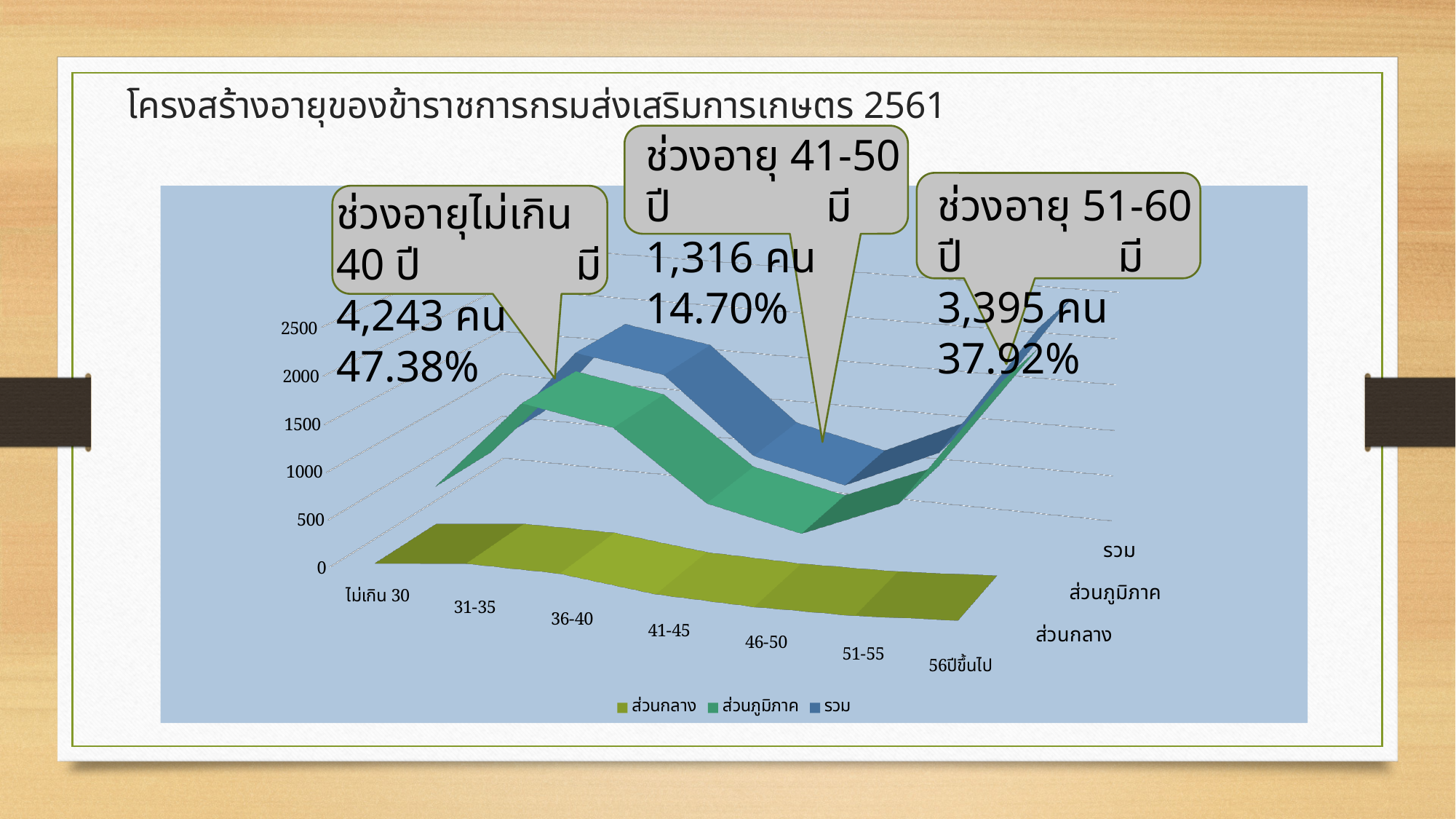
What is the title of the slide's chart? โครงสร้างอายุของข้าราชการกรมส่งเสริมการเกษตร 2561 How many series does the chart legend list? 3 Which series is shown in blue in the chart legend? รวม What is the first age category on the x axis of the chart? ไม่เกิน 30 What is the last age category on the x axis of the chart? 56ปีขึ้นไป What kind of chart is shown on the slide? 3D line chart What is the highest tick value shown on the vertical axis of the chart? 2500 How many age categories are shown along the x axis of the chart? 7